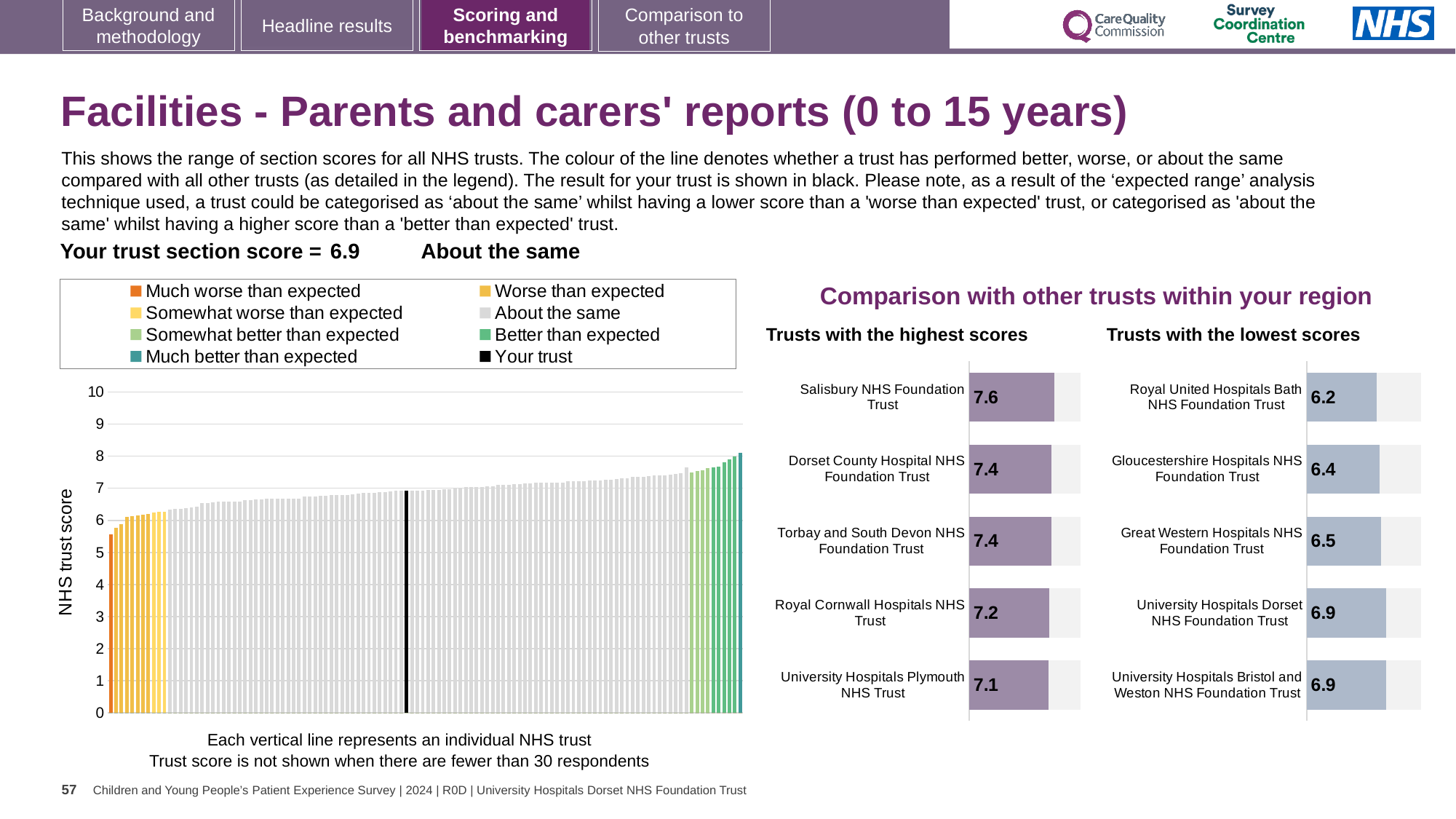
On the 'Trusts with the lowest scores' chart, what is the score for Royal United Hospitals Bath NHS Foundation Trust? 6.2 On the 'Trusts with the highest scores' chart, what is the difference between the scores of Salisbury NHS Foundation Trust and University Hospitals Plymouth NHS Trust? 0.5 On the 'Trusts with the lowest scores' chart, what is the difference between the scores of Great Western Hospitals NHS Foundation Trust and Royal United Hospitals Bath NHS Foundation Trust? 0.3 On the 'Trusts with the lowest scores' chart, which has the larger score: Gloucestershire Hospitals NHS Foundation Trust or Great Western Hospitals NHS Foundation Trust? Great Western Hospitals NHS Foundation Trust On the 'Trusts with the highest scores' chart, what is the score for Salisbury NHS Foundation Trust? 7.6 On the main 'NHS trust score' chart on the left, is the value of the lowest (orange) bar greater or less than 6? less On the 'Trusts with the highest scores' chart, what is the score for University Hospitals Plymouth NHS Trust? 7.1 How many trusts are listed on the 'Trusts with the lowest scores' chart? 5 On the 'Trusts with the lowest scores' chart, which trust has the lowest score? Royal United Hospitals Bath NHS Foundation Trust What kind of chart is the main 'NHS trust score' chart on the left? bar chart On the 'Trusts with the highest scores' chart, which trust has the highest score? Salisbury NHS Foundation Trust On the main 'NHS trust score' chart on the left, what is the section score for your trust (the black line)? 6.9